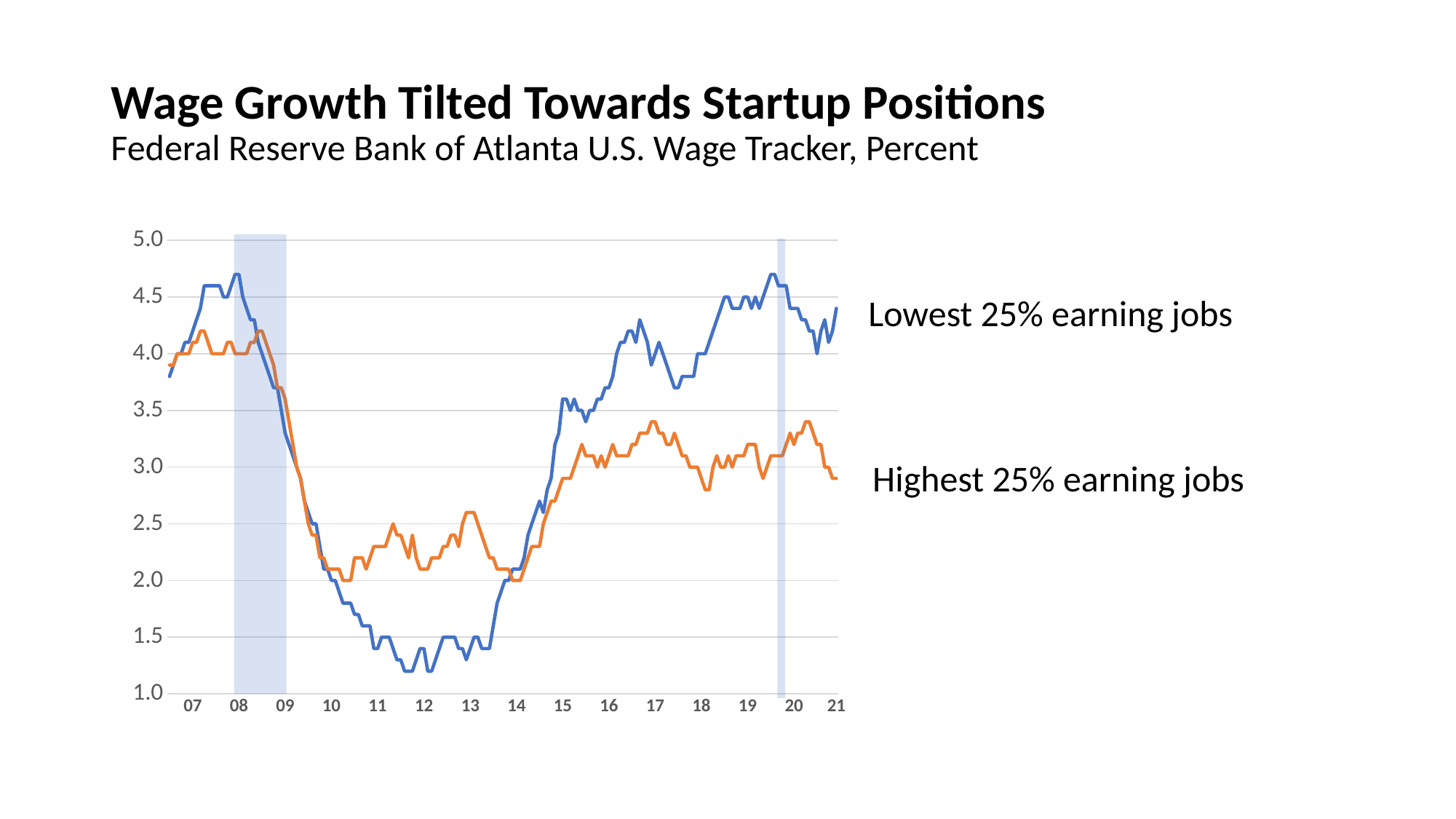
At 21, which series has the higher value: Lowest 25% earning jobs or Highest 25% earning jobs? Lowest 25% earning jobs Is the value for Highest 25% earning jobs at 21 greater or less than 3.0? less Is the value for Highest 25% earning jobs at 17 greater or less than 3.0? greater Is the value for Lowest 25% earning jobs at 12 greater or less than 1.5? less What is the title of the chart on the slide? Wage Growth Tilted Towards Startup Positions Which series is drawn in orange? Highest 25% earning jobs What kind of chart is shown on the slide? Line chart How many series are plotted on the chart? 2 How many year labels are shown on the x axis? 15 Does the Lowest 25% earning jobs series rise or fall between 08 and 12? Fall At 12, which series has the higher value: Lowest 25% earning jobs or Highest 25% earning jobs? Highest 25% earning jobs